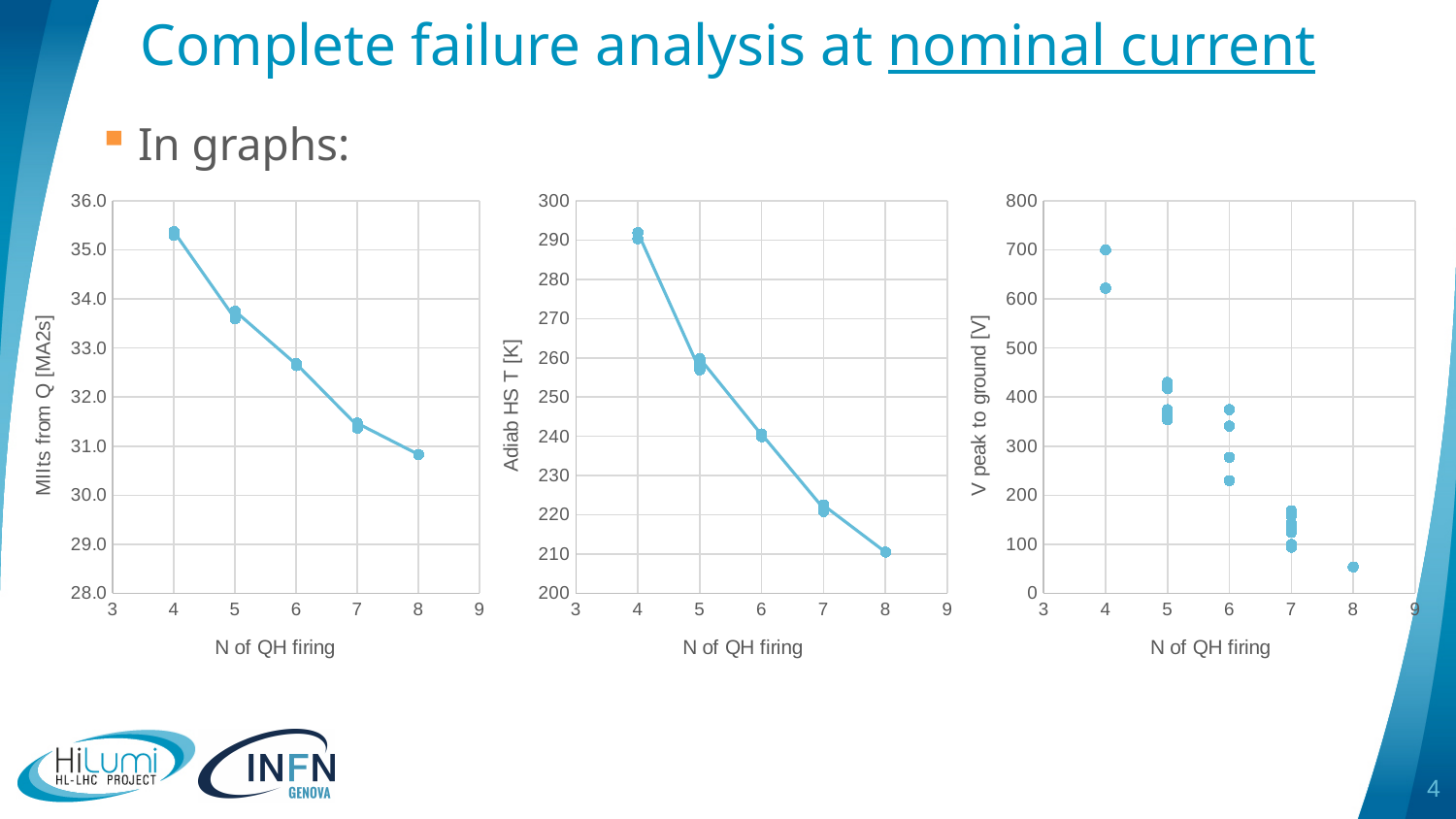
In the middle chart (Adiab HS T), is the value at N of QH firing = 4 greater or less than 280? greater In the left chart (MIIts from Q), which N of QH firing has the highest MIIts value? 4 In the middle chart (Adiab HS T), is the value at N of QH firing = 7 greater or less than 230? less In the right chart (V peak to ground), is the highest point at N of QH firing = 4 greater or less than 600? greater In the right chart (V peak to ground), how many distinct N of QH firing values have data points plotted? 5 What is the x-axis label shared by all three charts on the slide? N of QH firing In the left chart (MIIts from Q), does the value fall or rise as N of QH firing increases from 4 to 8? fall In the middle chart (Adiab HS T), does the temperature rise or fall as N of QH firing increases? fall In the middle chart (Adiab HS T), which N of QH firing has the lowest temperature? 8